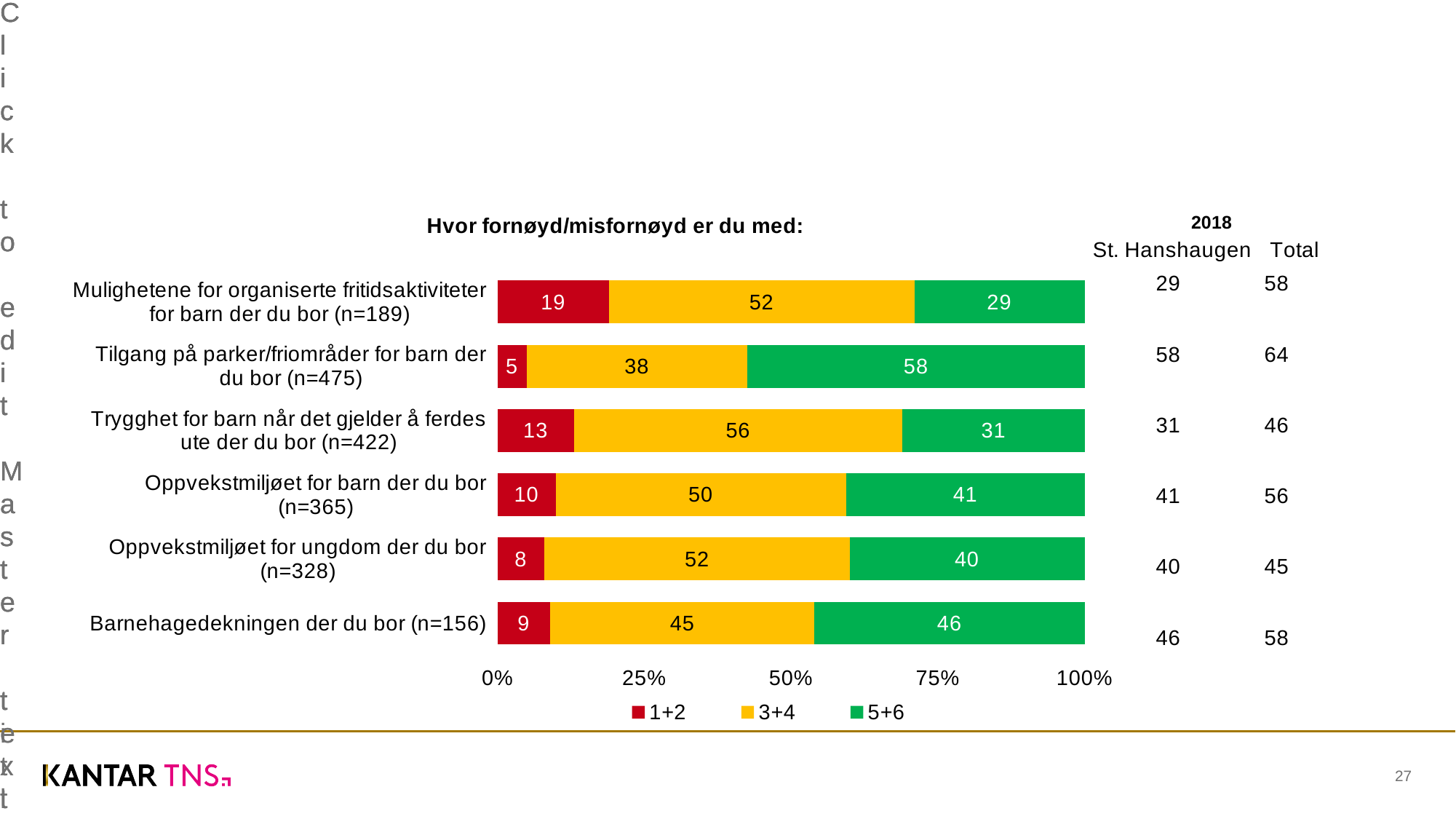
How many categories are shown in the chart? 6 What is the value of the 5+6 series for "Tilgang på parker/friområder for barn der du bor (n=475)"? 58 Which is larger: the 3+4 value for "Oppvekstmiljøet for barn der du bor (n=365)" or the 3+4 value for "Barnehagedekningen der du bor (n=156)"? Oppvekstmiljøet for barn der du bor (n=365) What is the title of the chart? Hvor fornøyd/misfornøyd er du med: Which category has the lowest value in the 1+2 series? Tilgang på parker/friområder for barn der du bor (n=475) What is the value of the 3+4 series for "Trygghet for barn når det gjelder å ferdes ute der du bor (n=422)"? 56 Which category has the highest value in the 5+6 series? Tilgang på parker/friområder for barn der du bor (n=475) What is the total of the stacked bar for "Oppvekstmiljøet for ungdom der du bor (n=328)"? 100 What is the difference between the 5+6 values for "Barnehagedekningen der du bor (n=156)" and "Mulighetene for organiserte fritidsaktiviteter for barn der du bor (n=189)"? 17 What is the value of the 1+2 series for "Mulighetene for organiserte fritidsaktiviteter for barn der du bor (n=189)"? 19 What kind of chart is shown on the slide? Stacked bar chart How many series does the legend list? 3